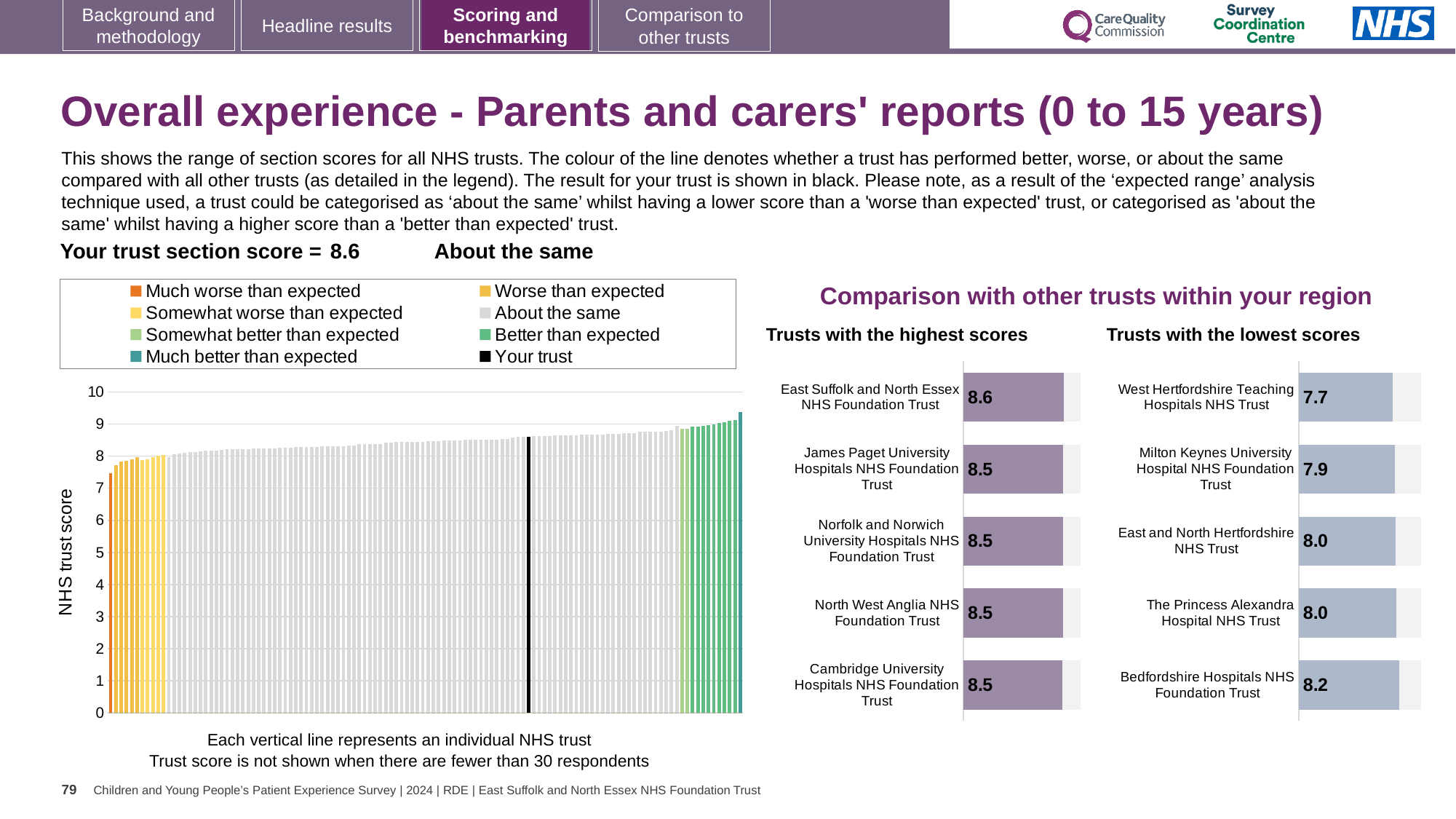
In the large 'NHS trust score' chart on the left, do the bar values rise or fall from left to right? rise In the large 'NHS trust score' chart on the left, is the value of the lowest (leftmost) bar greater or less than 8? less In the 'Trusts with the lowest scores' chart, what is the score for West Hertfordshire Teaching Hospitals NHS Trust? 7.7 In the 'Trusts with the lowest scores' chart, which has the larger score: Milton Keynes University Hospital NHS Foundation Trust or Bedfordshire Hospitals NHS Foundation Trust? Bedfordshire Hospitals NHS Foundation Trust How many trusts are listed in the 'Trusts with the highest scores' chart? 5 In the 'Trusts with the highest scores' chart, what is the difference between the scores of East Suffolk and North Essex NHS Foundation Trust and James Paget University Hospitals NHS Foundation Trust? 0.1 In the 'Trusts with the highest scores' chart, what is the score for East Suffolk and North Essex NHS Foundation Trust? 8.6 In the 'Trusts with the lowest scores' chart, which trust has the lowest score? West Hertfordshire Teaching Hospitals NHS Trust In the 'Trusts with the lowest scores' chart, what is the difference between the scores of Bedfordshire Hospitals NHS Foundation Trust and West Hertfordshire Teaching Hospitals NHS Trust? 0.5 How many entries does the legend of the large 'NHS trust score' chart list? 8 In the 'Trusts with the lowest scores' chart, what is the score for Bedfordshire Hospitals NHS Foundation Trust? 8.2 In the 'Trusts with the highest scores' chart, which trust has the highest score? East Suffolk and North Essex NHS Foundation Trust